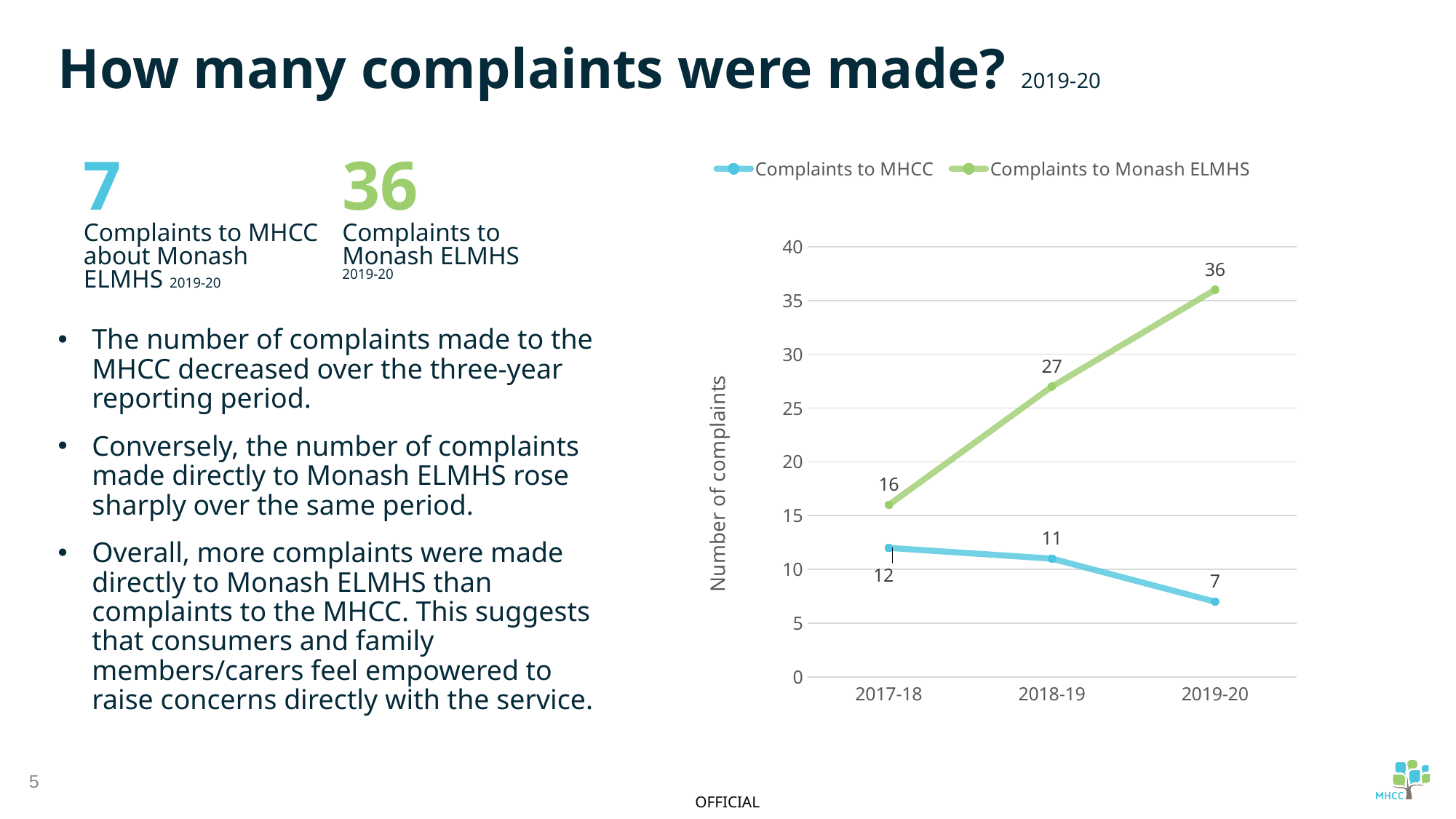
What is the difference between Complaints to Monash ELMHS and Complaints to MHCC in 2019-20? 29 How many periods are shown on the x axis of the chart? 3 What kind of chart is shown on the slide? line chart What is the value for Complaints to Monash ELMHS in 2018-19? 27 In which period were Complaints to MHCC lowest? 2019-20 What is the value for Complaints to MHCC in 2017-18? 12 Which series has the larger value in 2017-18, Complaints to MHCC or Complaints to Monash ELMHS? Complaints to Monash ELMHS In which period were Complaints to Monash ELMHS highest? 2019-20 What is the value for Complaints to Monash ELMHS in 2019-20? 36 Do the values for Complaints to MHCC rise or fall from 2017-18 to 2019-20? fall How many series does the chart legend list? 2 What is the value for Complaints to MHCC in 2019-20? 7